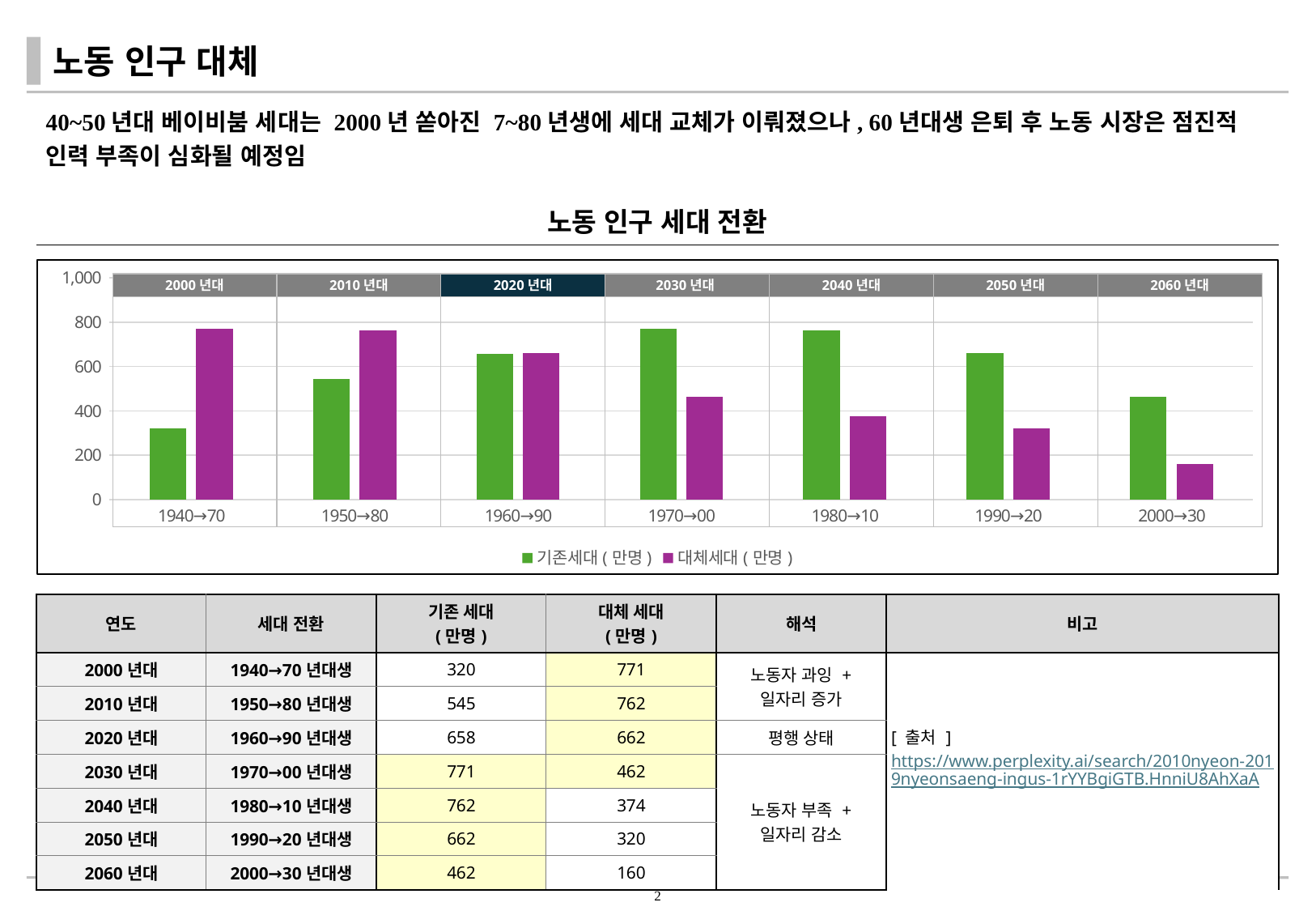
Is the value of 대체세대 (만명) for 2000→30 greater or less than 200? less How many series does the chart legend list? 2 Which category has the lowest 대체세대 (만명) value? 2000→30 What kind of chart is shown under the title 노동 인구 세대 전환? bar chart For 1940→70, which is larger: 기존세대 or 대체세대? 대체세대 Do the 대체세대 (만명) values rise or fall from 1940→70 to 2000→30? fall How many generation-transition categories are shown on the x axis of the chart? 7 Which category has the lowest 기존세대 (만명) value? 1940→70 What is the difference between 대체세대 and 기존세대 for 1940→70? 451 What is the value of 대체세대 (만명) for 2000→30? 160 What is the value of 기존세대 (만명) for 1940→70? 320 What is the value of 대체세대 (만명) for 1960→90? 662